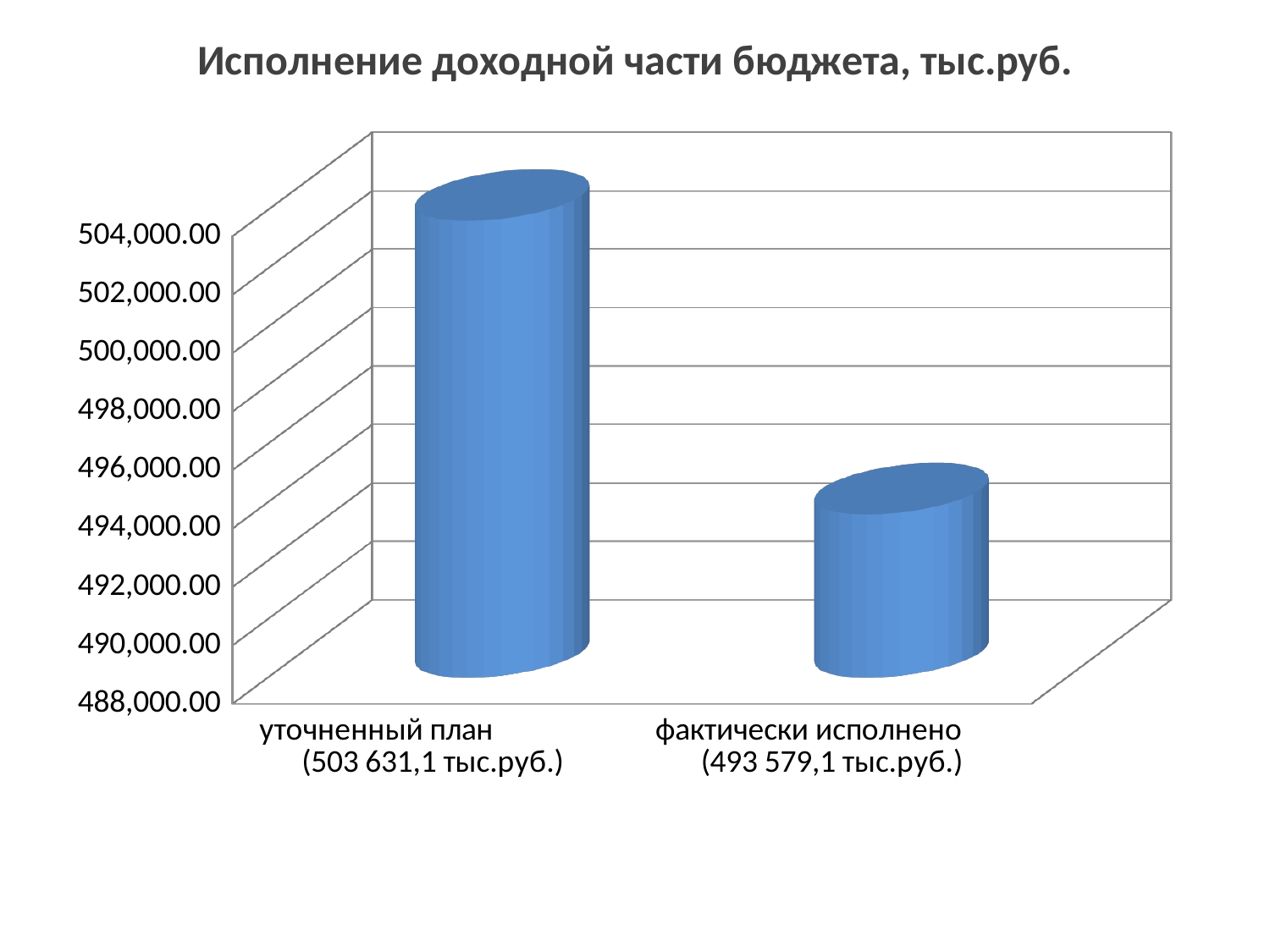
Which category has the lowest value? фактически исполнено Which category has the highest value? уточненный план What is the value for "фактически исполнено"? 493 579,1 тыс.руб. How many categories (bars) are plotted in the chart? 2 Do the values rise or fall from left to right along the x axis? fall What type of chart is shown on the slide? Bar chart What is the difference between the value for "уточненный план" and the value for "фактически исполнено"? 10 052,0 тыс.руб. What is the value for "уточненный план"? 503 631,1 тыс.руб. Is the value for "уточненный план" greater or less than 500,000.00? greater Which is larger, the value for "уточненный план" or for "фактически исполнено"? уточненный план Is the value for "фактически исполнено" greater or less than 496,000.00? less What is the title of the chart? Исполнение доходной части бюджета, тыс.руб.